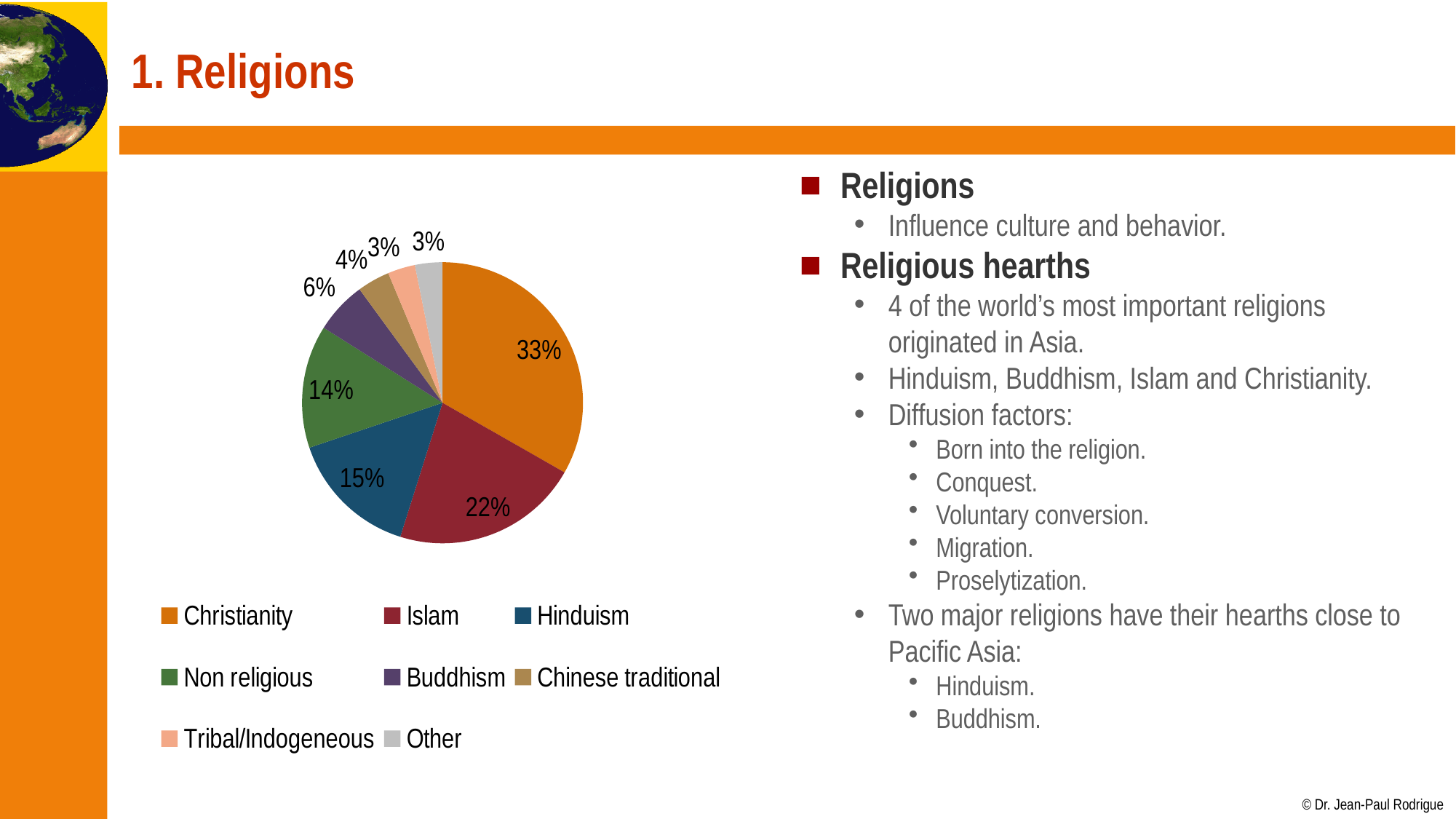
What kind of chart is shown on the slide? Pie chart What is the value shown for Hinduism? 15% What share of the pie does Christianity hold? 33% Which category has the largest slice of the pie? Christianity How many categories does the legend list? 8 Which is larger, the share for Hinduism or the share for Buddhism? Hinduism What is the combined share of Islam and Hinduism? 37% What is the value shown for Buddhism? 6% What colour is the Christianity slice in the pie chart? Orange What is the difference between the Christianity and Islam shares? 11% What is the value shown for Non religious? 14% What is the value shown for Islam? 22%